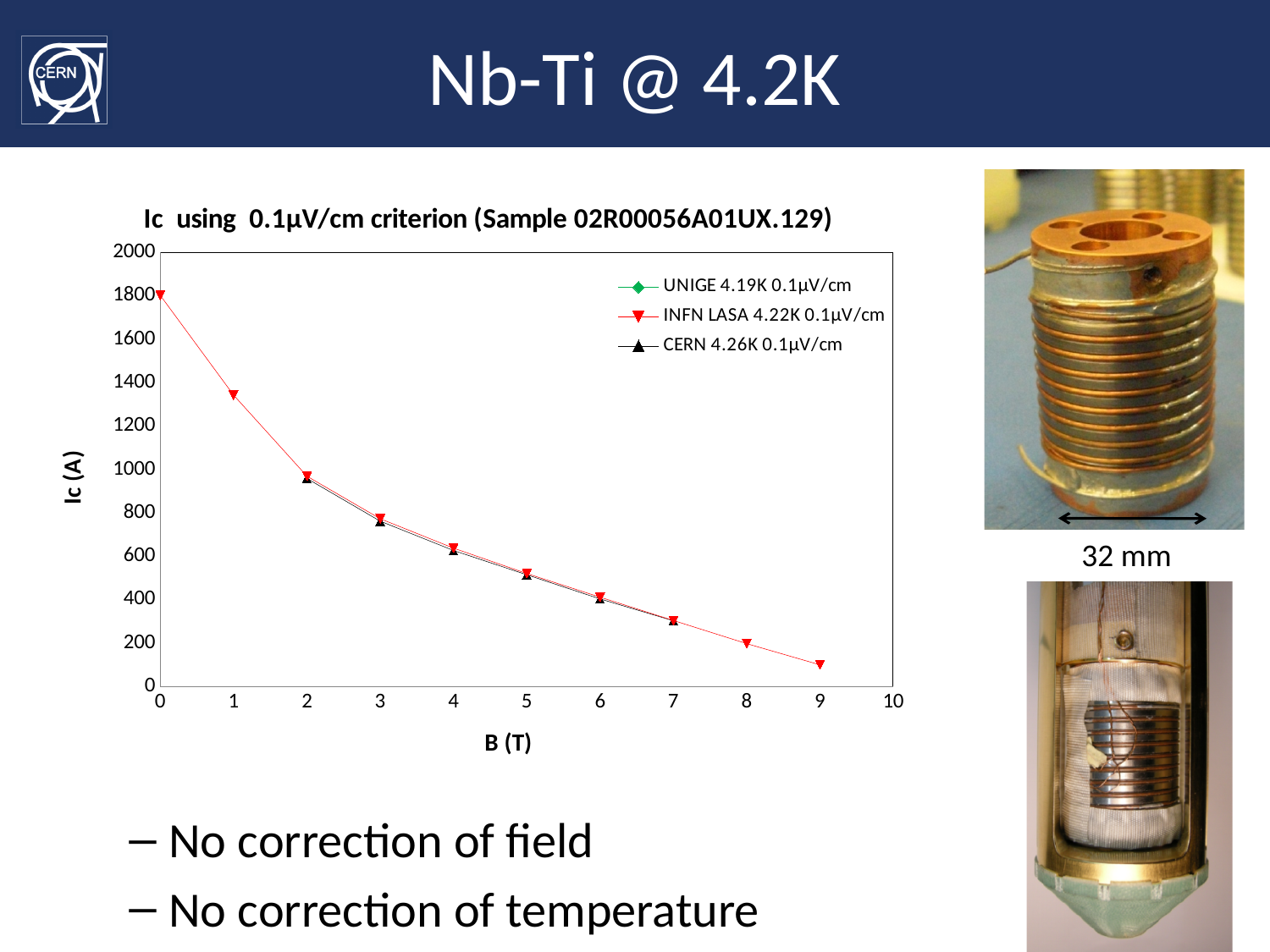
Is the INFN LASA 4.22K value at B = 5 T greater or less than 400? greater At which B value does the INFN LASA 4.22K series reach its highest Ic? 0 What is the label of the x axis of the chart? B (T) Is the INFN LASA 4.22K value at B = 3 T greater or less than 600? greater Do the Ic values rise or fall as B increases along the x axis? fall What kind of chart is shown on the slide? line chart What is the title of the chart? Ic using 0.1µV/cm criterion (Sample 02R00056A01UX.129) Which is larger for the INFN LASA 4.22K series: the value at B = 1 T or the value at B = 6 T? B = 1 T Is the INFN LASA 4.22K value at B = 9 T greater or less than 200? less How many series does the chart legend list? 3